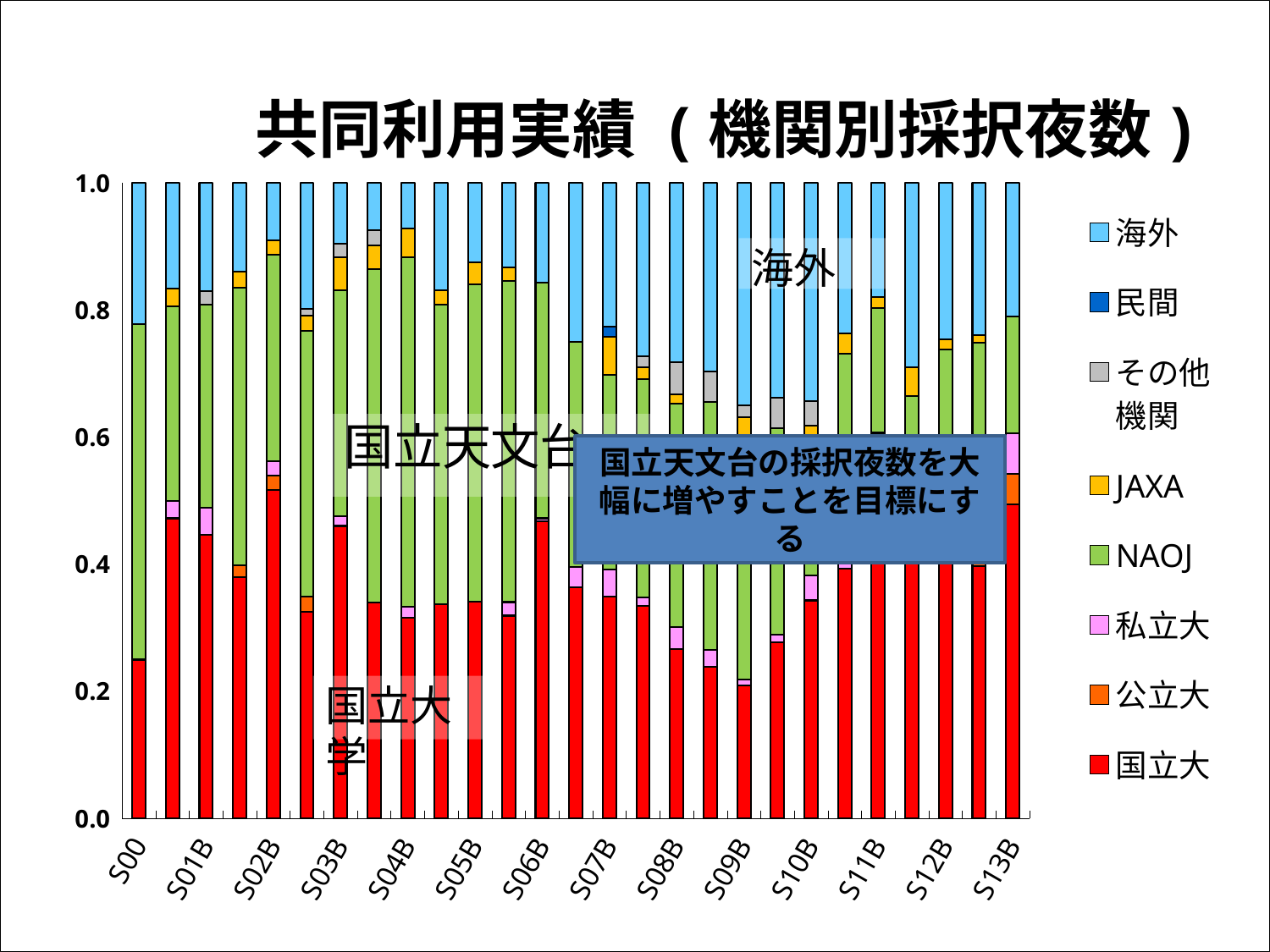
Is the 国立大 value for S00 greater or less than 0.4? less How many series does the legend list? 8 Is the 国立大 value for S00 greater or less than 0.2? greater What kind of chart is shown on the slide? stacked bar chart What is the title of the chart? 共同利用実績（機関別採択夜数） Is the 国立大 value for S04B greater or less than 0.4? less Which colour represents 国立大 in the chart? red What is the total height of the S00 stacked bar on the y axis? 1.0 How many category labels are printed along the x axis? 14 Which has the larger 国立大 value, S00 or S02B? S02B